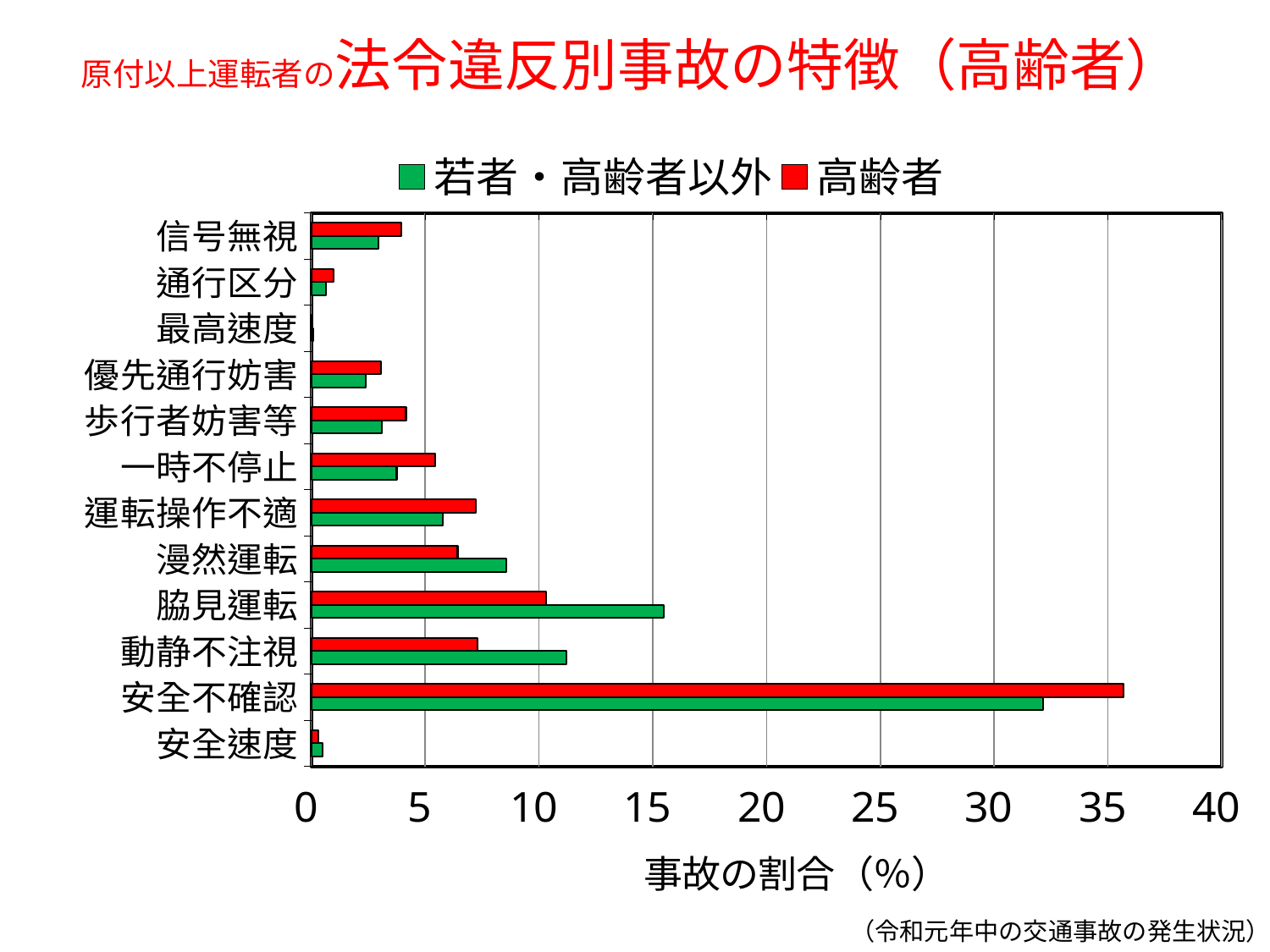
Is the value for 高齢者 in 安全不確認 greater or less than 35? greater What kind of chart is shown on the slide? bar chart Which category has the highest value for 若者・高齢者以外? 安全不確認 How many series does the legend list? 2 Which category has the highest value for 高齢者? 安全不確認 For 脇見運転, which series has the larger value, 若者・高齢者以外 or 高齢者? 若者・高齢者以外 Is the value for 若者・高齢者以外 in 脇見運転 greater or less than 15? greater How many violation categories are plotted on the y axis? 12 What colour represents the 高齢者 series in the legend? red Is the value for 高齢者 in 漫然運転 greater or less than 10? less For 動静不注視, which series has the larger value, 若者・高齢者以外 or 高齢者? 若者・高齢者以外 For 安全不確認, which series has the larger value, 若者・高齢者以外 or 高齢者? 高齢者